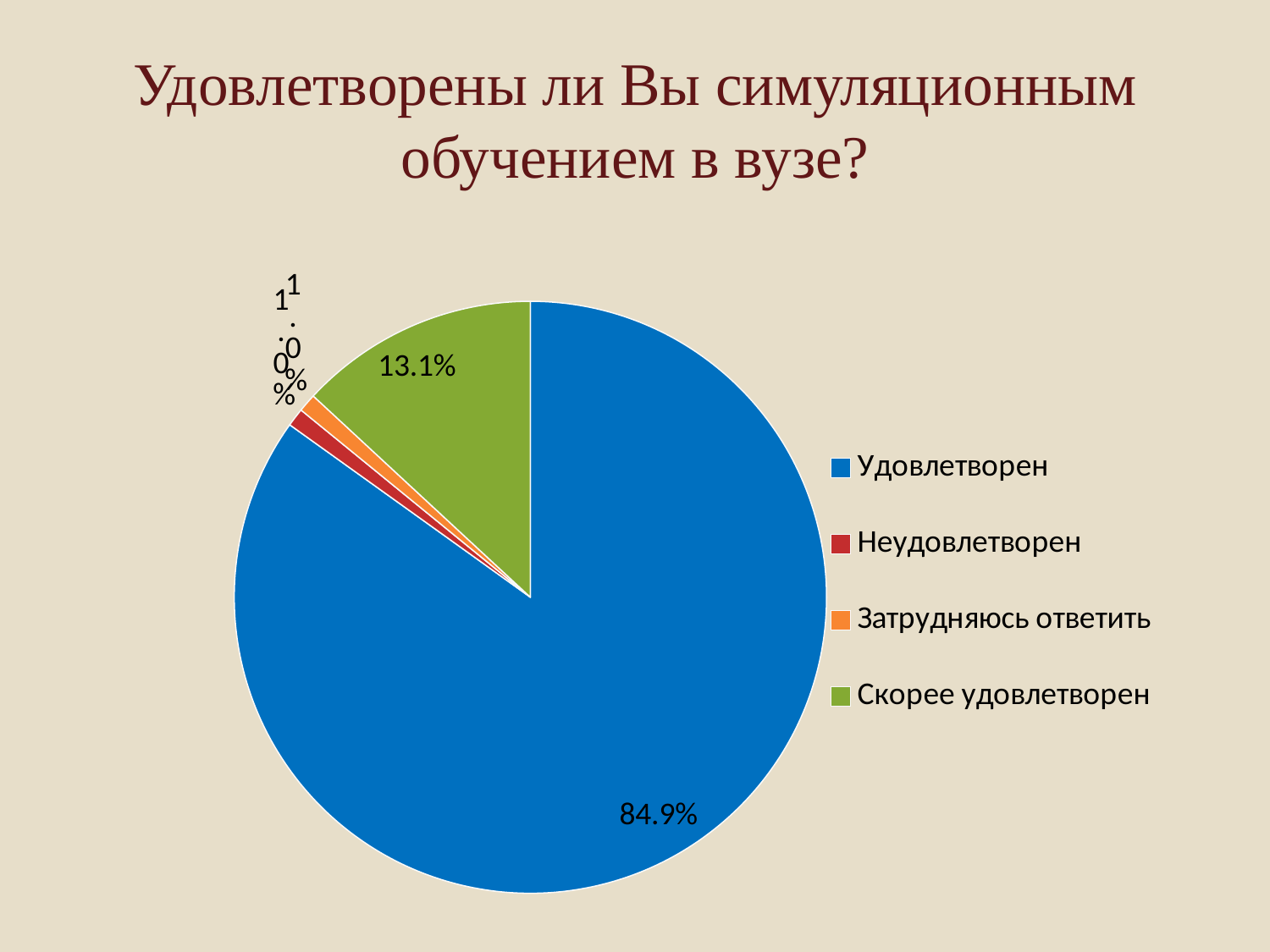
Which is smaller: the share for "Скорее удовлетворен" or the share for "Неудовлетворен"? Неудовлетворен Which answer category has the largest share of the pie? Удовлетворен What kind of chart is shown on the slide? pie chart What is the difference in percentage points between the "Удовлетворен" share and the "Скорее удовлетворен" share? 71.8 What percentage of respondents answered "Удовлетворен"? 84.9% What percentage of respondents answered "Скорее удовлетворен"? 13.1% What share of the pie does the "Скорее удовлетворен" slice represent? 13.1% How many categories (slices) does the pie chart have? 4 Which is larger: the share for "Удовлетворен" or the share for "Скорее удовлетворен"? Удовлетворен Is the share for "Удовлетворен" greater or less than 50%? greater What colour is the "Удовлетворен" slice in the pie chart? blue How many entries does the legend list? 4